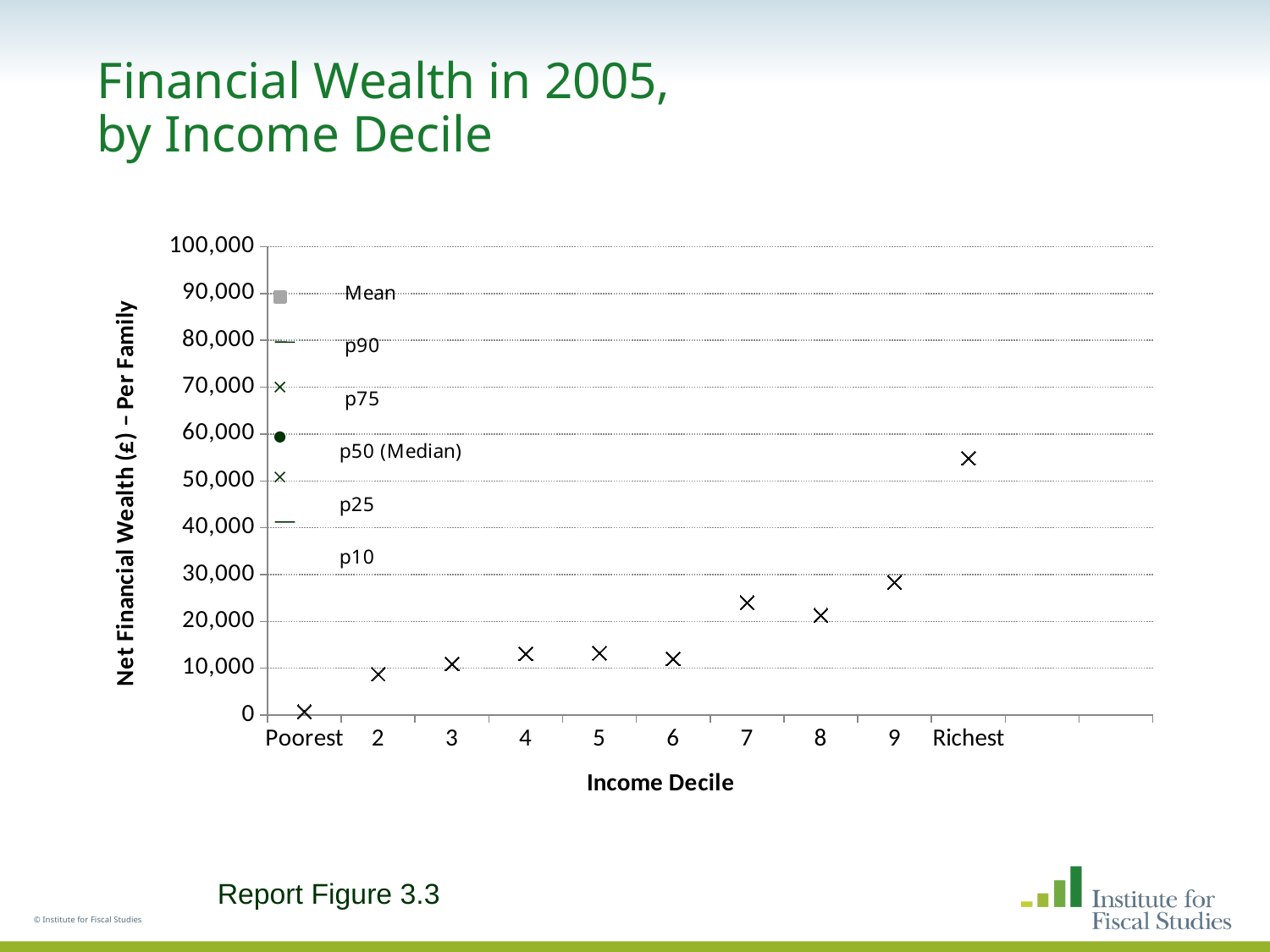
Is the plotted value for the Richest decile greater or less than 50,000? greater How many series does the legend list? 6 What is the title of the y axis? Net Financial Wealth (£) – Per Family Is the plotted value for decile 7 greater or less than 20,000? greater Which income decile has the highest plotted net financial wealth? Richest Which has the larger plotted value, decile 9 or decile 6? 9 What type of chart is shown on the slide? scatter chart Do the plotted values generally rise or fall from the Poorest to the Richest decile? rise Which income decile has the lowest plotted net financial wealth? Poorest How many income deciles are shown along the x axis? 10